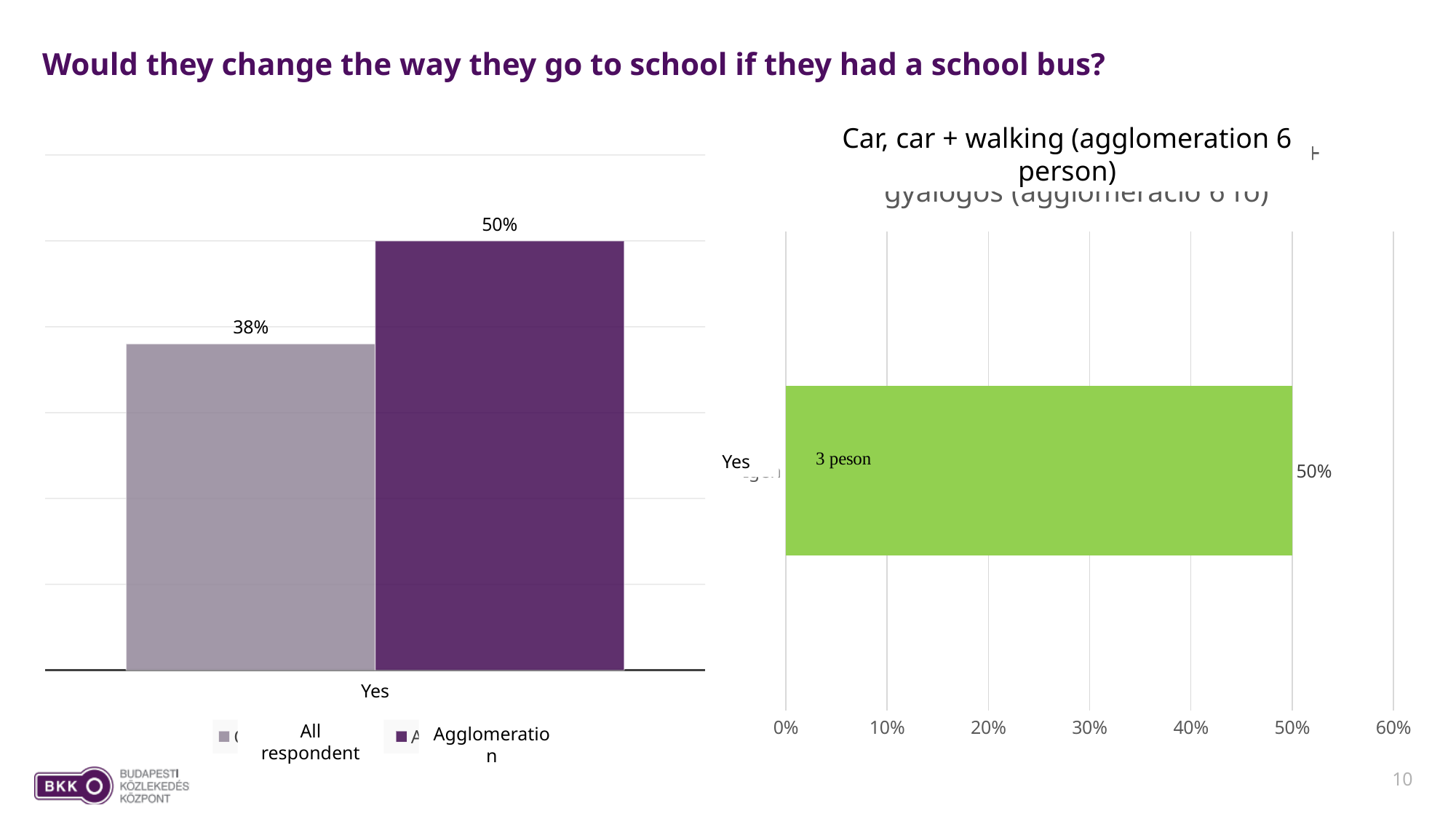
In the left chart, what is the value for All respondent? 38% What kind of chart is the left chart? bar chart In the left chart, what is the difference between the Agglomeration value and the All respondent value? 12% What is the highest value shown on the x axis of the right chart? 60% What kind of chart is the right chart? bar chart In the right chart, is the value for Yes greater or less than 40%? greater How many series does the legend of the left chart list? 2 In the chart titled 'Car, car + walking (agglomeration 6 person)', what is the percentage value for Yes? 50% In the chart titled 'Car, car + walking (agglomeration 6 person)', what label is printed inside the bar? 3 peson What category label appears on the x axis of the left chart? Yes In the left chart, what is the value for Agglomeration? 50% In the left chart, which series has the higher value for Yes: All respondent or Agglomeration? Agglomeration